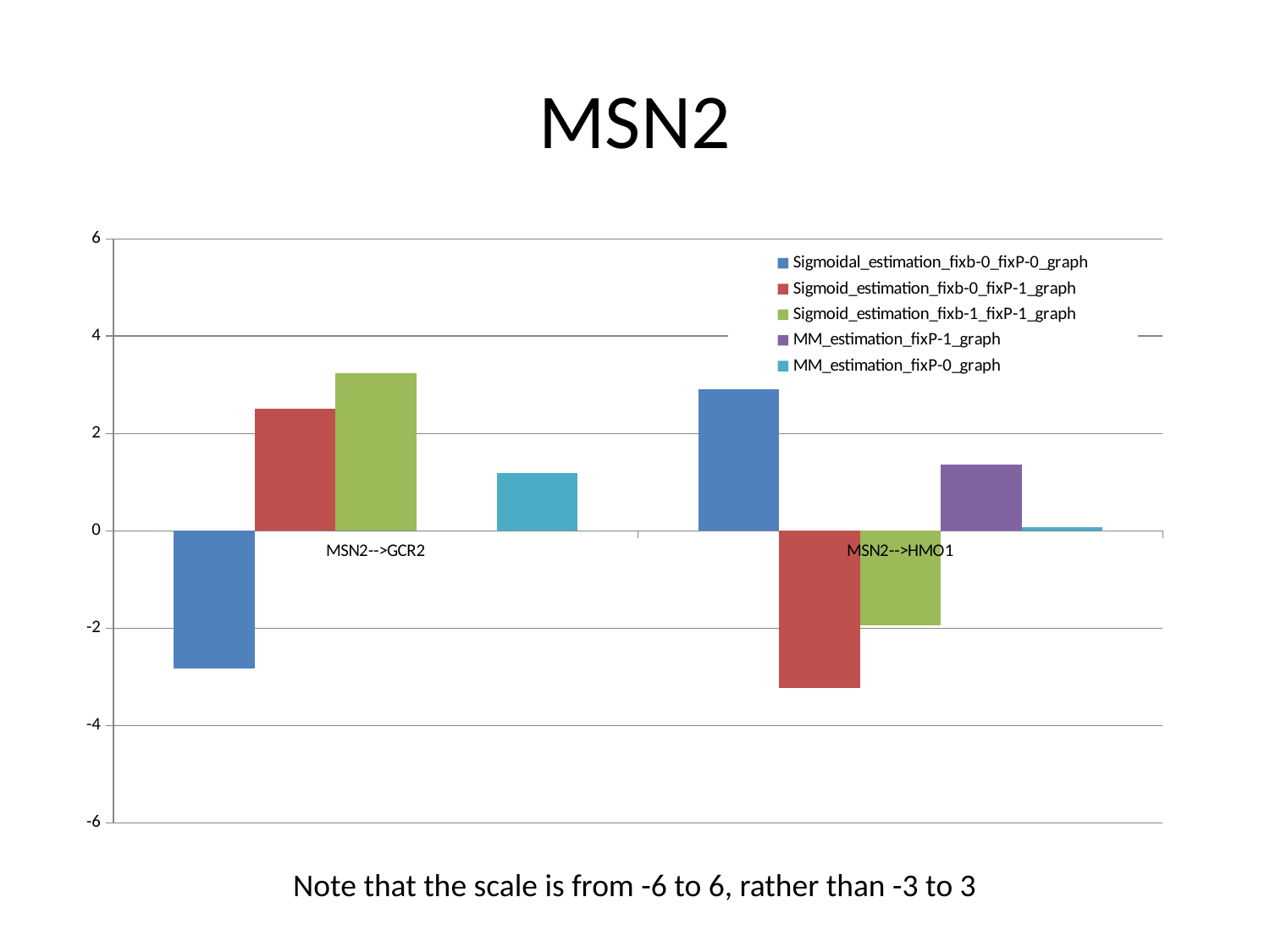
What is the title of the chart? MSN2 Is the value of Sigmoidal_estimation_fixb-0_fixP-0_graph for MSN2-->GCR2 greater or less than -2? less How many categories are shown on the x axis of the chart? 2 Is the value of Sigmoid_estimation_fixb-0_fixP-1_graph for MSN2-->HMO1 greater or less than -2? less How many series does the legend list? 5 What kind of chart is shown on the slide? Bar chart Is the value of MM_estimation_fixP-1_graph for MSN2-->HMO1 greater or less than 2? less Which series has the highest value for MSN2-->GCR2? Sigmoid_estimation_fixb-1_fixP-1_graph Which series is listed first in the legend? Sigmoidal_estimation_fixb-0_fixP-0_graph For MSN2-->GCR2, which is larger: Sigmoid_estimation_fixb-1_fixP-1_graph or Sigmoid_estimation_fixb-0_fixP-1_graph? Sigmoid_estimation_fixb-1_fixP-1_graph Which series has the lowest value for MSN2-->HMO1? Sigmoid_estimation_fixb-0_fixP-1_graph